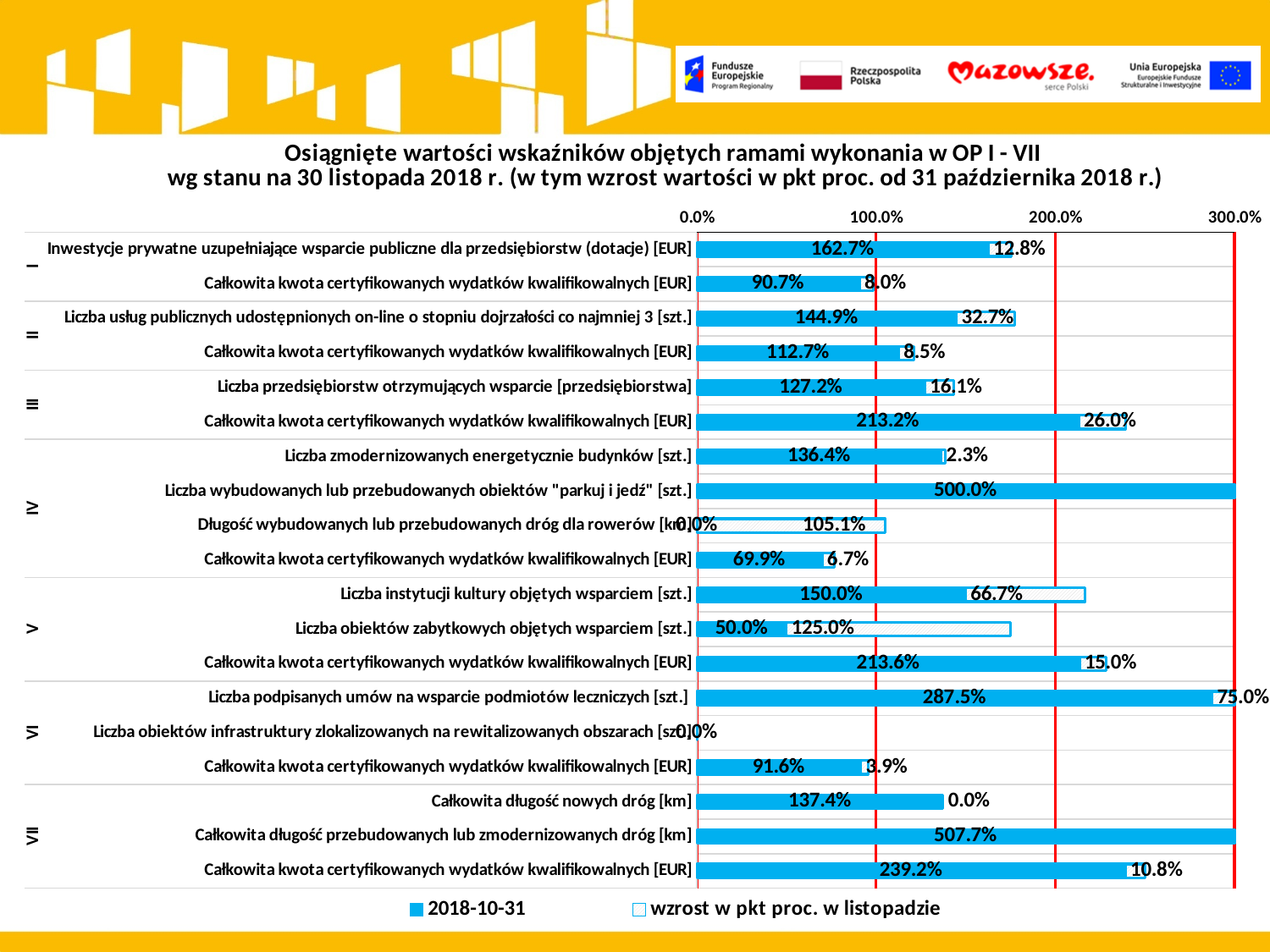
What is the difference between the 2018-10-31 values of "Inwestycje prywatne uzupełniające wsparcie publiczne dla przedsiębiorstw (dotacje) [EUR]" and "Całkowita kwota certyfikowanych wydatków kwalifikowalnych [EUR]" in OP I? 72.0 percentage points What is the 2018-10-31 value for "Całkowita kwota certyfikowanych wydatków kwalifikowalnych [EUR]" in OP VII? 239.2% What type of chart is shown on the slide? bar chart What is the 2018-10-31 value for "Liczba usług publicznych udostępnionych on-line o stopniu dojrzałości co najmniej 3 [szt.]"? 144.9% How many indicators (categories) are plotted in the chart? 19 Which is larger: the 2018-10-31 value for "Liczba podpisanych umów na wsparcie podmiotów leczniczych [szt.]" or for "Liczba przedsiębiorstw otrzymujących wsparcie [przedsiębiorstwa]"? Liczba podpisanych umów na wsparcie podmiotów leczniczych [szt.] What is the total of the stacked bar for "Liczba instytucji kultury objętych wsparciem [szt.]"? 216.7% What is the "wzrost w pkt proc. w listopadzie" value for "Liczba instytucji kultury objętych wsparciem [szt.]"? 66.7% How many series does the legend list? 2 Which indicator has the highest 2018-10-31 value? Całkowita długość przebudowanych lub zmodernizowanych dróg [km] Is the 2018-10-31 value for "Liczba zmodernizowanych energetycznie budynków [szt.]" greater or less than 100.0%? greater